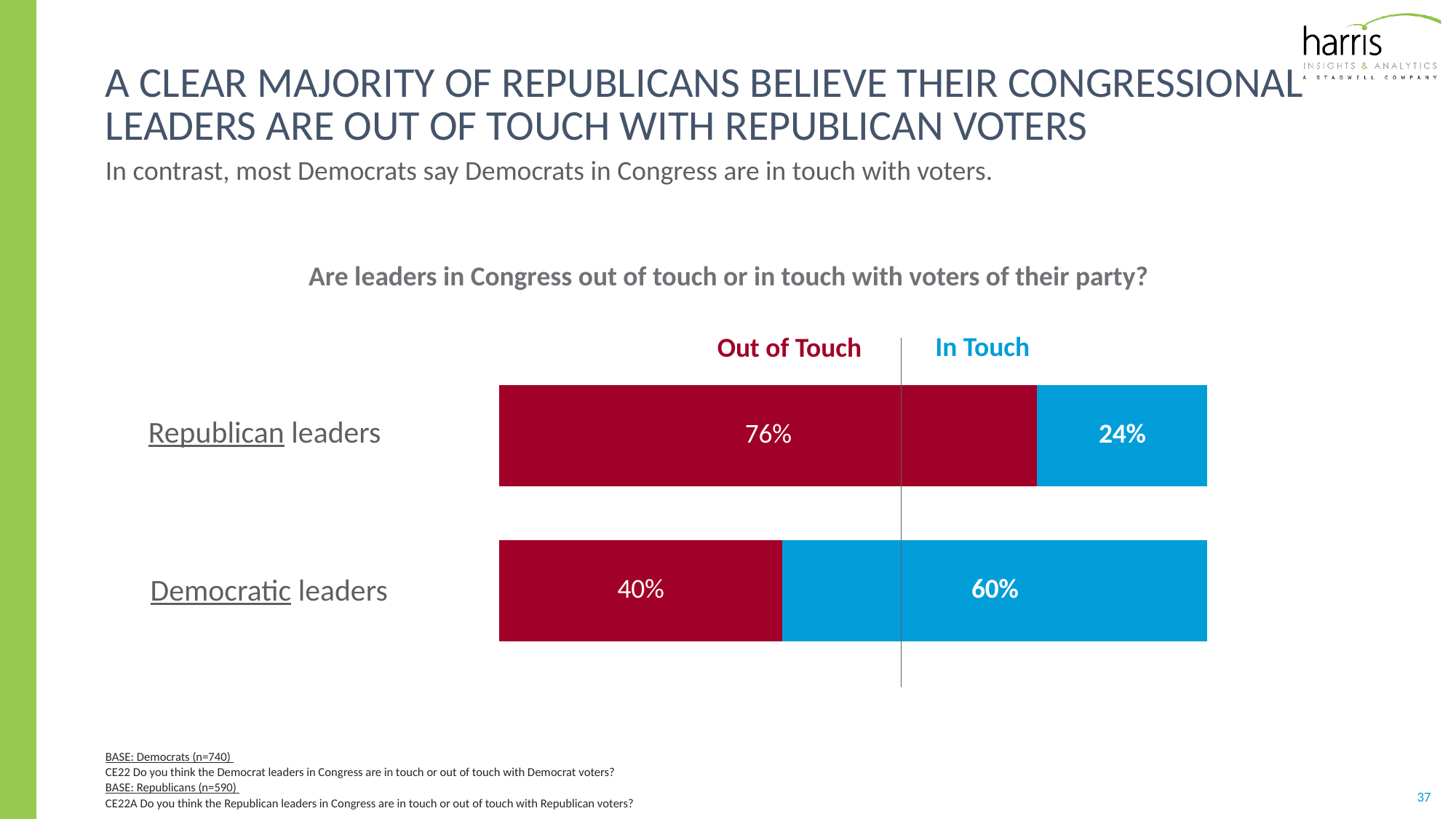
What is the difference between the 'In Touch' and 'Out of Touch' percentages for Democratic leaders? 20 percentage points What percentage say Republican leaders are in touch? 24% Which group of leaders has the higher 'Out of Touch' percentage? Republican leaders What is the difference between the 'Out of Touch' percentages for Republican leaders and Democratic leaders? 36 percentage points Is the 'In Touch' value for Democratic leaders larger or smaller than the 'In Touch' value for Republican leaders? larger How many series does the chart show? 2 What percentage say Democratic leaders are out of touch? 40% What type of chart is shown on the slide? Stacked bar chart Which group of leaders has the lower 'In Touch' percentage? Republican leaders What percentage say Republican leaders are out of touch? 76% How many categories (groups of leaders) are shown in the chart? 2 What percentage say Democratic leaders are in touch? 60%